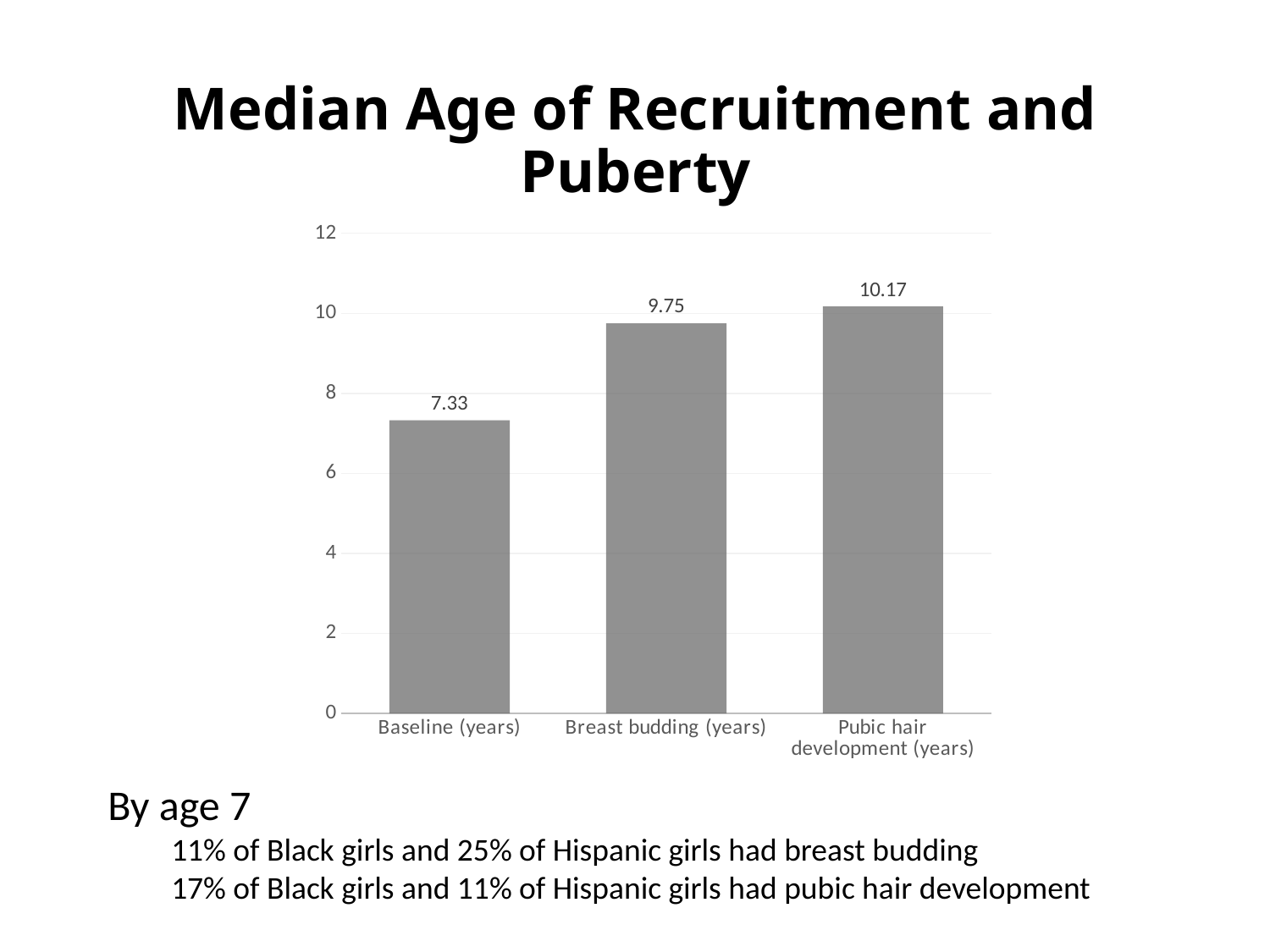
What is the value for Pubic hair development (years)? 10.17 What is the difference between the values for Breast budding (years) and Baseline (years)? 2.42 What kind of chart is shown on the slide? bar chart What is the value for Baseline (years)? 7.33 What is the difference between the values for Pubic hair development (years) and Baseline (years)? 2.84 What is the value for Breast budding (years)? 9.75 Which category has the lowest value? Baseline (years) What is the title of the chart? Median Age of Recruitment and Puberty How many categories are shown on the chart? 3 Which category has the highest value? Pubic hair development (years) Which is larger, the value for Breast budding (years) or Baseline (years)? Breast budding (years) Is the value for Breast budding (years) greater or less than 10? less